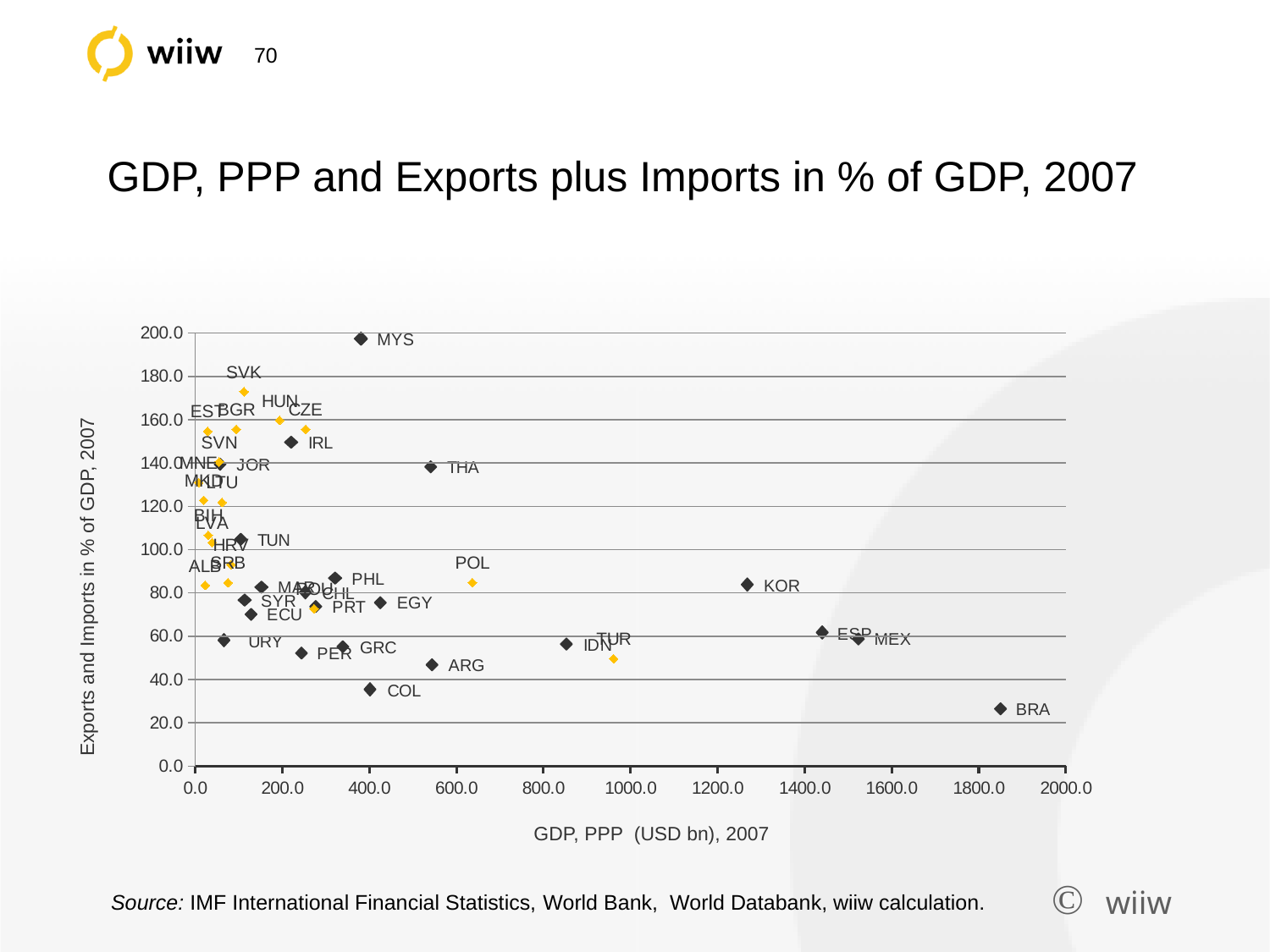
What kind of chart is shown on the slide? scatter chart Which country has the largest GDP, PPP (furthest right on the x axis)? BRA Is the exports and imports value for POL greater or less than 100.0? less Is the exports and imports value for MYS greater or less than 180.0? greater Which has the larger GDP, PPP, MEX or KOR? MEX Which has the higher exports and imports in % of GDP, THA or ARG? THA Is the exports and imports value for BRA greater or less than 40.0? less What is the title of the chart? GDP, PPP and Exports plus Imports in % of GDP, 2007 Which country has the lowest exports and imports in % of GDP? BRA Which country has the highest exports and imports in % of GDP? MYS What is the label of the horizontal axis? GDP, PPP (USD bn), 2007